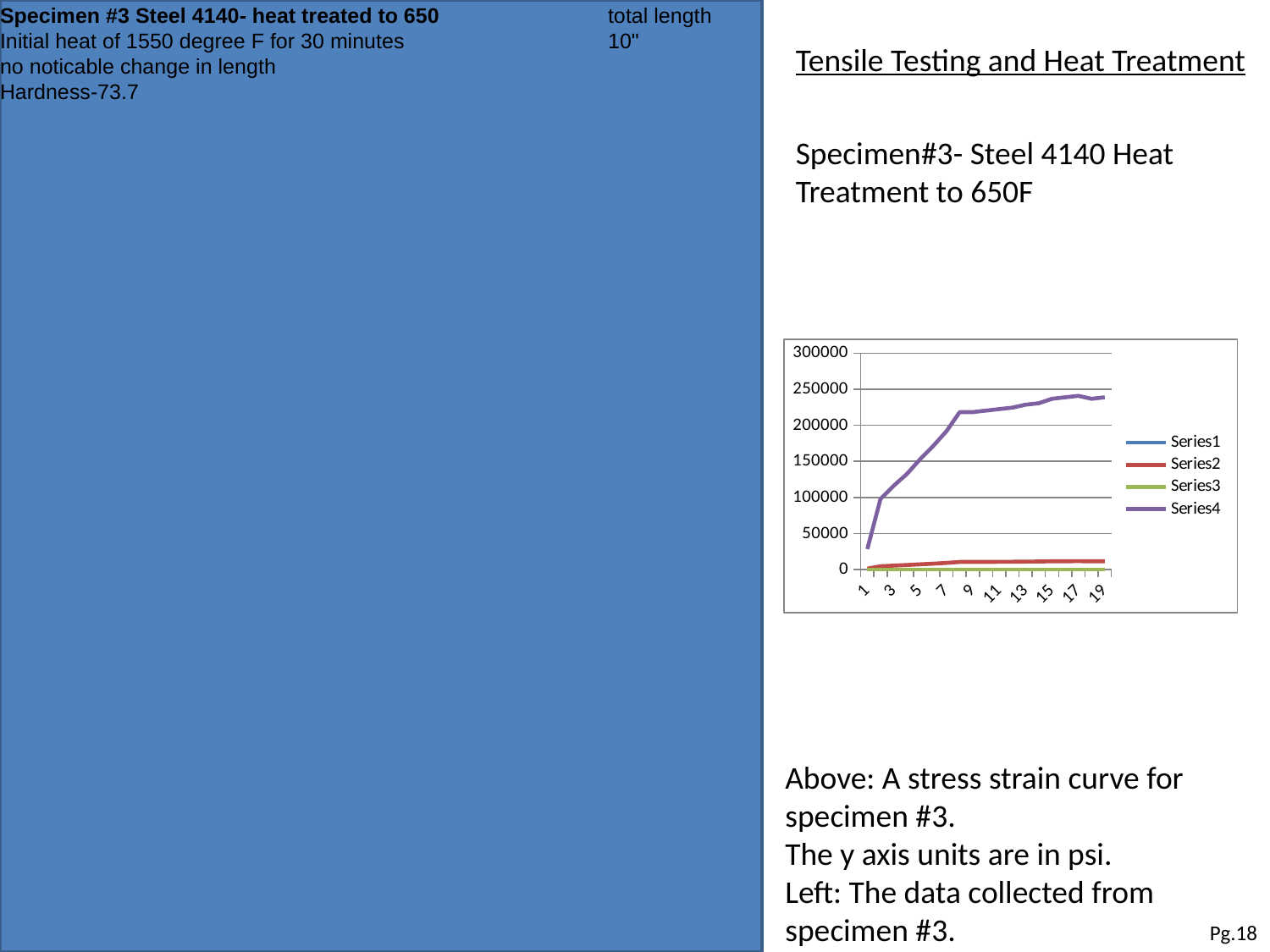
Is the value of Series4 at x = 9 greater or less than 200000? greater How many series does the chart's legend list? 4 Is the value of Series4 at x = 19 greater or less than 250000? less Is the value of Series4 at x = 5 greater or less than 100000? greater What is the highest value labelled on the chart's y axis? 300000 Which series has the highest values in the chart? Series4 What colour is the line for Series4 in the chart? purple Does Series4 generally rise or fall along the x axis? rise At x = 19, which is larger, Series4 or Series2? Series4 What kind of chart is shown on the slide? line chart